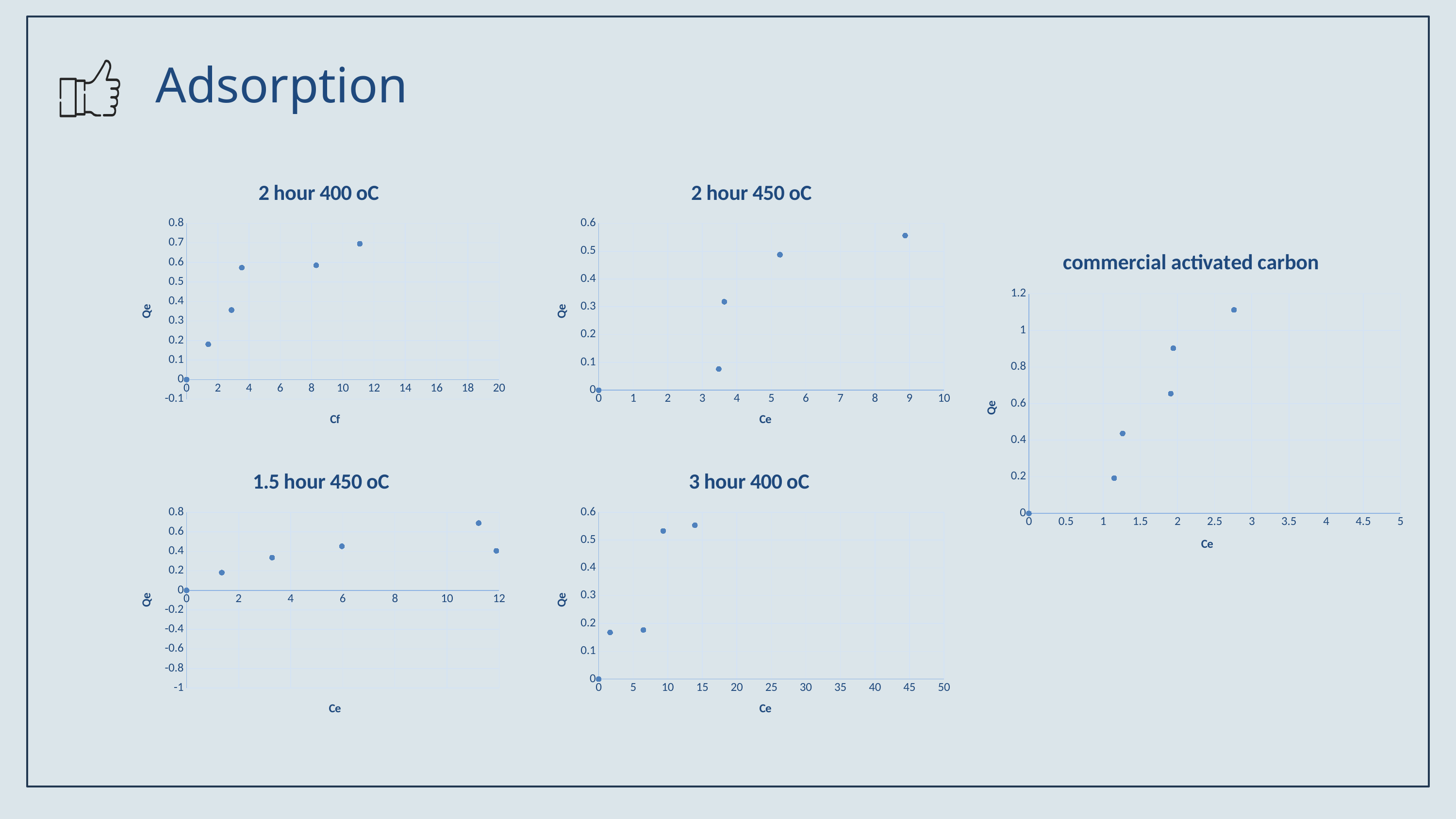
What is the x-axis title of the "2 hour 400 oC" chart? Cf How many charts are shown on the slide? 5 In the "2 hour 450 oC" chart, is the highest Qe value greater or less than 0.5? greater What kind of chart is the "commercial activated carbon" chart? scatter chart In the "commercial activated carbon" chart, do the Qe values generally rise or fall as Ce increases? rise In the "3 hour 400 oC" chart, how many data points are plotted? 5 What is the y-axis title of the "1.5 hour 450 oC" chart? Qe In the "2 hour 450 oC" chart, how many data points are plotted? 5 In the "2 hour 400 oC" chart, is the highest Qe value greater or less than 0.6? greater In the "3 hour 400 oC" chart, is the Qe value of the point at Ce of about 1.5 greater or less than 0.2? less